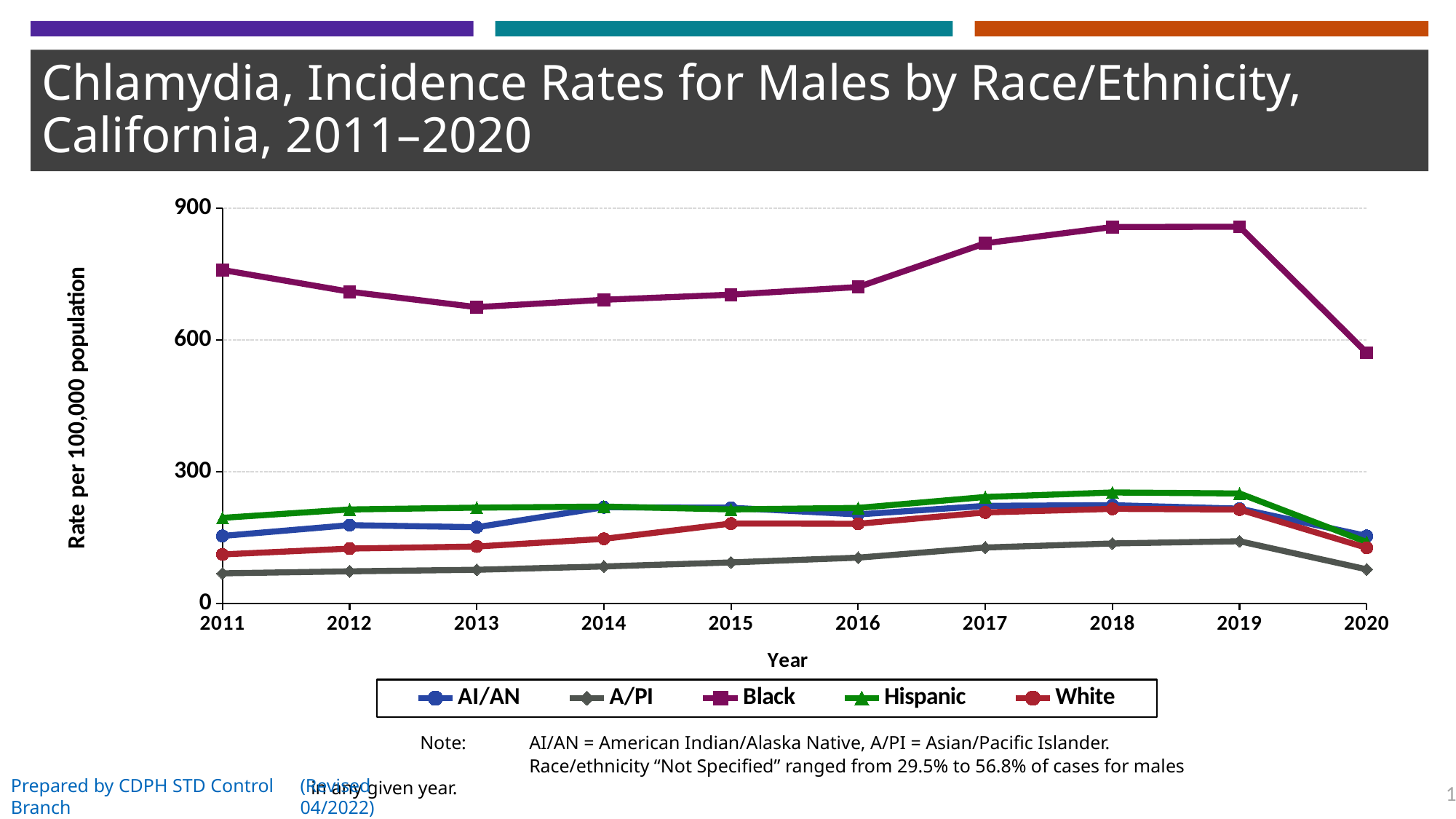
What is the label of the y axis? Rate per 100,000 population Which is larger in 2011, the value for Hispanic or the value for A/PI? Hispanic Does the value for Black rise or fall from 2019 to 2020? fall Is the value for Black in 2020 greater or less than 600? less Which is larger in 2015, the value for Black or the value for White? Black How many years are plotted along the x axis? 10 How many series does the legend list? 5 Is the value for Hispanic in 2018 greater or less than 300? less Which race/ethnicity group has the lowest incidence rate in 2011? A/PI Is the value for Black in 2018 greater or less than 600? greater What kind of chart is shown on the slide? line chart Which race/ethnicity group has the highest incidence rate in 2018? Black